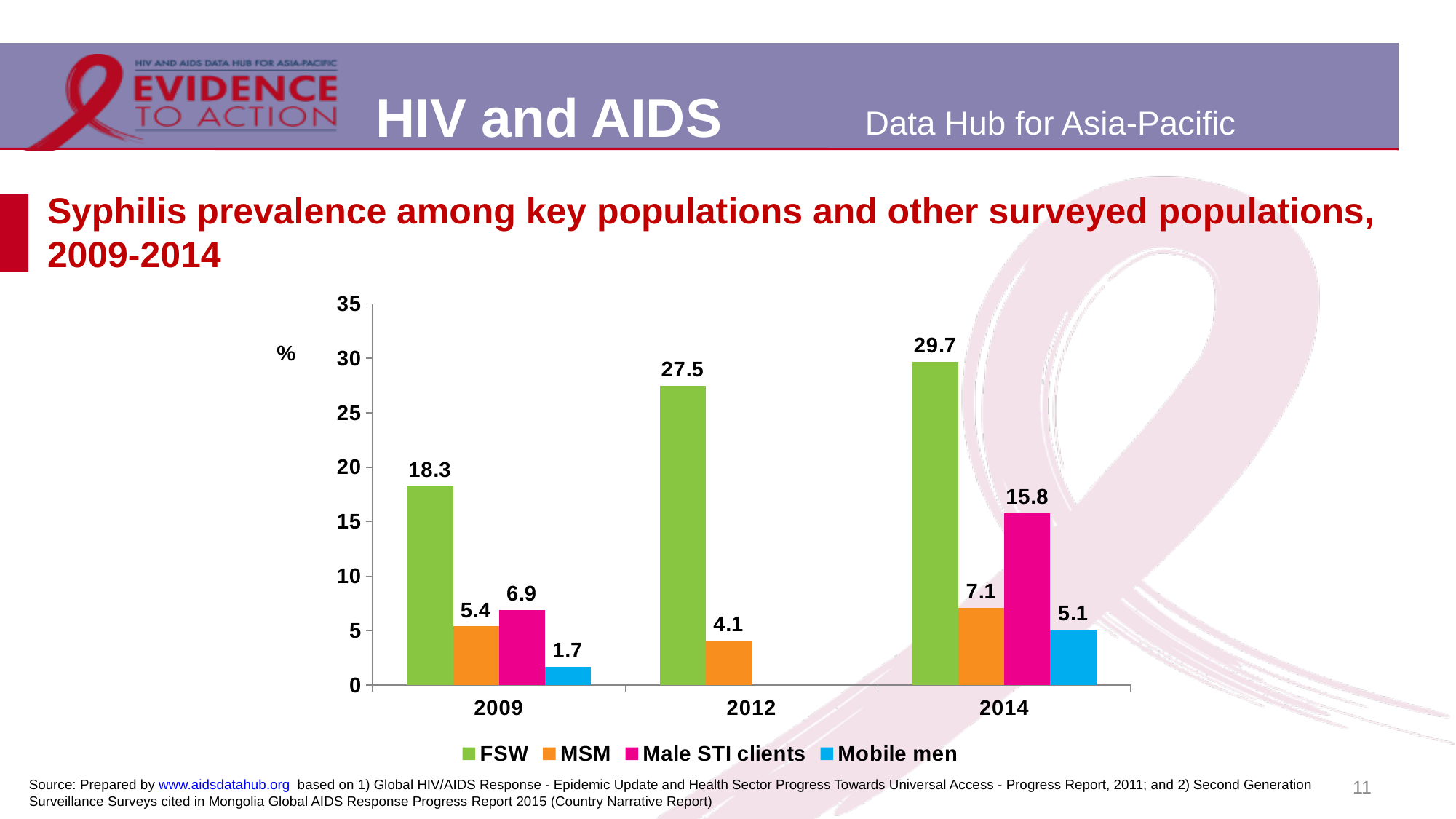
How many series does the legend list? 4 What is the syphilis prevalence among FSW in 2014? 29.7 Which year has the highest FSW value? 2014 How many years are shown on the x axis? 3 What is the value for Mobile men in 2009? 1.7 What is the difference between the FSW values in 2014 and 2009? 11.4 Which is larger, the MSM value in 2014 or the Male STI clients value in 2009? MSM in 2014 What is the value for MSM in 2012? 4.1 Does the FSW value rise or fall from 2009 to 2014? Rise Which population has the lowest value in 2009? Mobile men What is the value for Male STI clients in 2014? 15.8 What kind of chart is shown on the slide? Bar chart